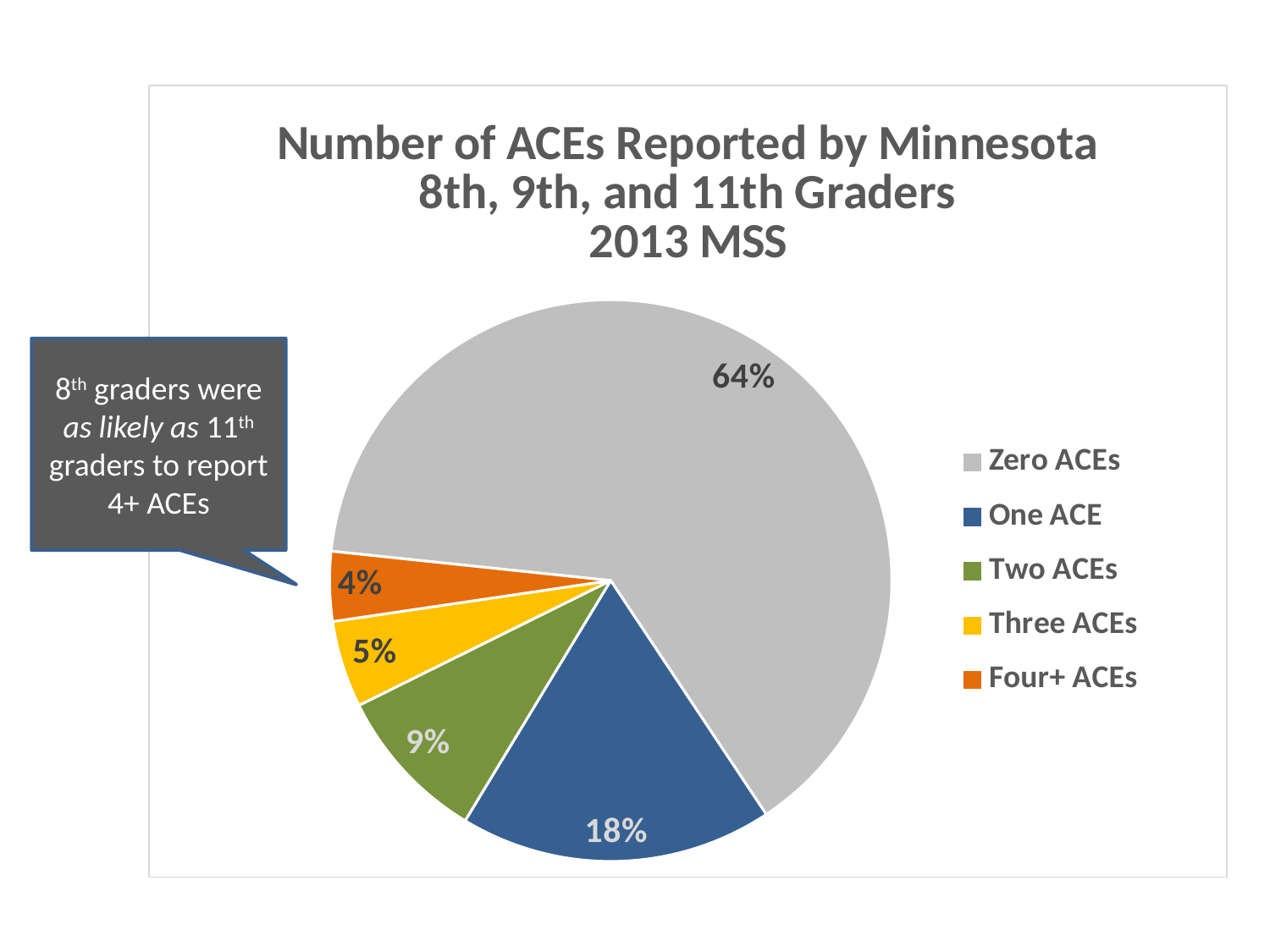
Which is larger, the share for Two ACEs or the share for Three ACEs? Two ACEs What percentage of students reported Zero ACEs? 64% What percentage of students reported Four+ ACEs? 4% What percentage of students reported Two ACEs? 9% What colour is the slice for Four+ ACEs? orange How many categories does the legend list? 5 What is the difference in percentage points between Zero ACEs and One ACE? 46 What type of chart is shown on the slide? pie chart What percentage of students reported Three ACEs? 5% Which category has the largest share of the pie? Zero ACEs Which category has the smallest share of the pie? Four+ ACEs What percentage of students reported One ACE? 18%